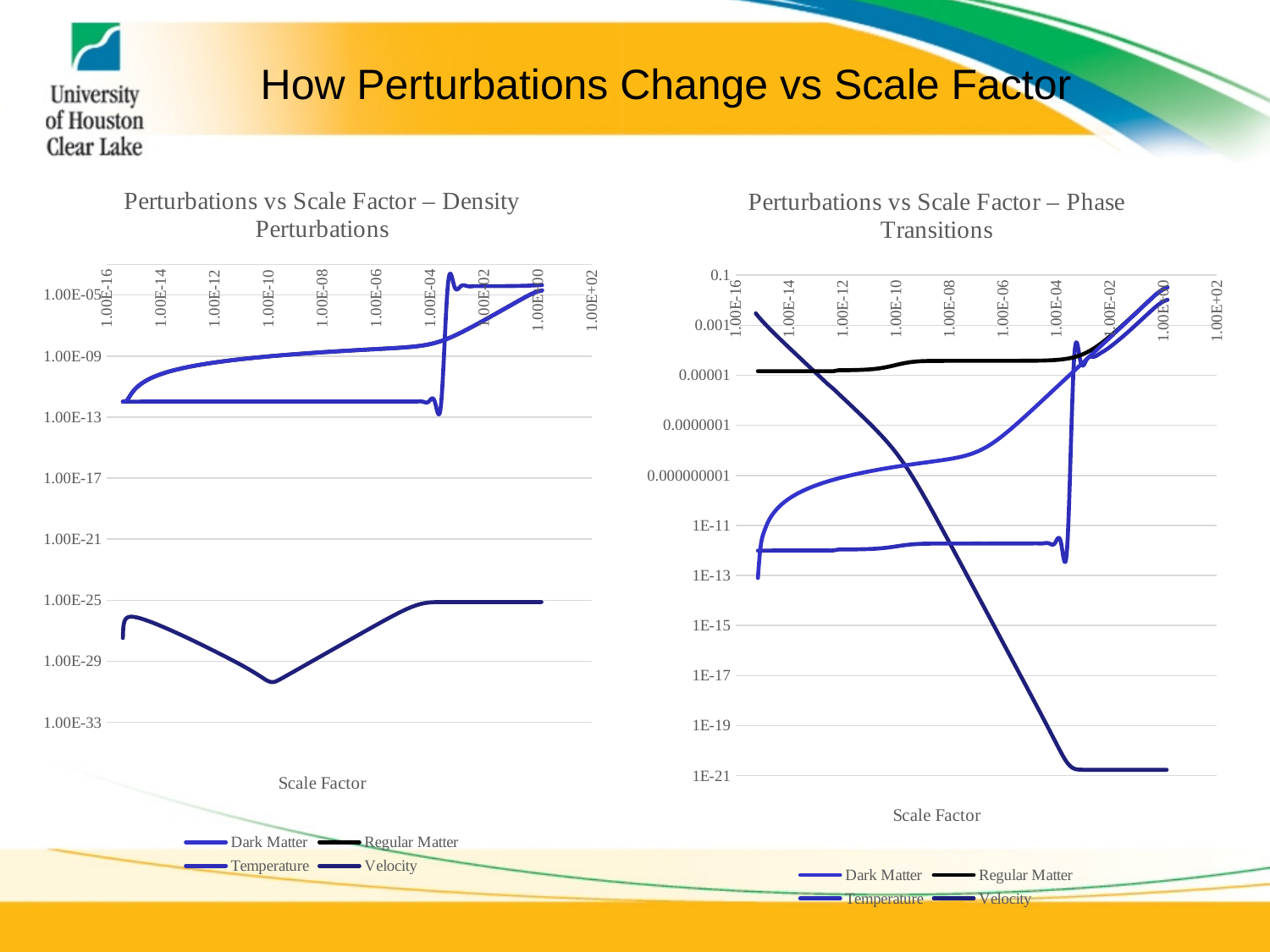
What kind of chart is the 'Perturbations vs Scale Factor – Density Perturbations' chart? line chart In the 'Perturbations vs Scale Factor – Phase Transitions' chart, does the Velocity series rise or fall along the x axis? fall In the 'Perturbations vs Scale Factor – Density Perturbations' chart, which series has the lowest value at scale factor 1.00E-10? Velocity What is the x-axis title of the 'Perturbations vs Scale Factor – Density Perturbations' chart? Scale Factor In the 'Perturbations vs Scale Factor – Phase Transitions' chart, is the Velocity value at scale factor 1.00E+00 greater or less than 1E-17? less In the 'Perturbations vs Scale Factor – Phase Transitions' chart, which series has the lowest value at scale factor 1.00E+00? Velocity In the 'Perturbations vs Scale Factor – Phase Transitions' chart, which is larger at scale factor 1.00E-10: Regular Matter or Velocity? Regular Matter In the 'Perturbations vs Scale Factor – Phase Transitions' chart, is the Regular Matter value at scale factor 1.00E-16 greater or less than 0.0000001? greater In the 'Perturbations vs Scale Factor – Density Perturbations' chart, is the Velocity value at scale factor 1.00E-10 greater or less than 1.00E-25? less How many series does the legend of the 'Perturbations vs Scale Factor – Phase Transitions' chart list? 4 What is the title of the chart on the right side of the slide? Perturbations vs Scale Factor – Phase Transitions